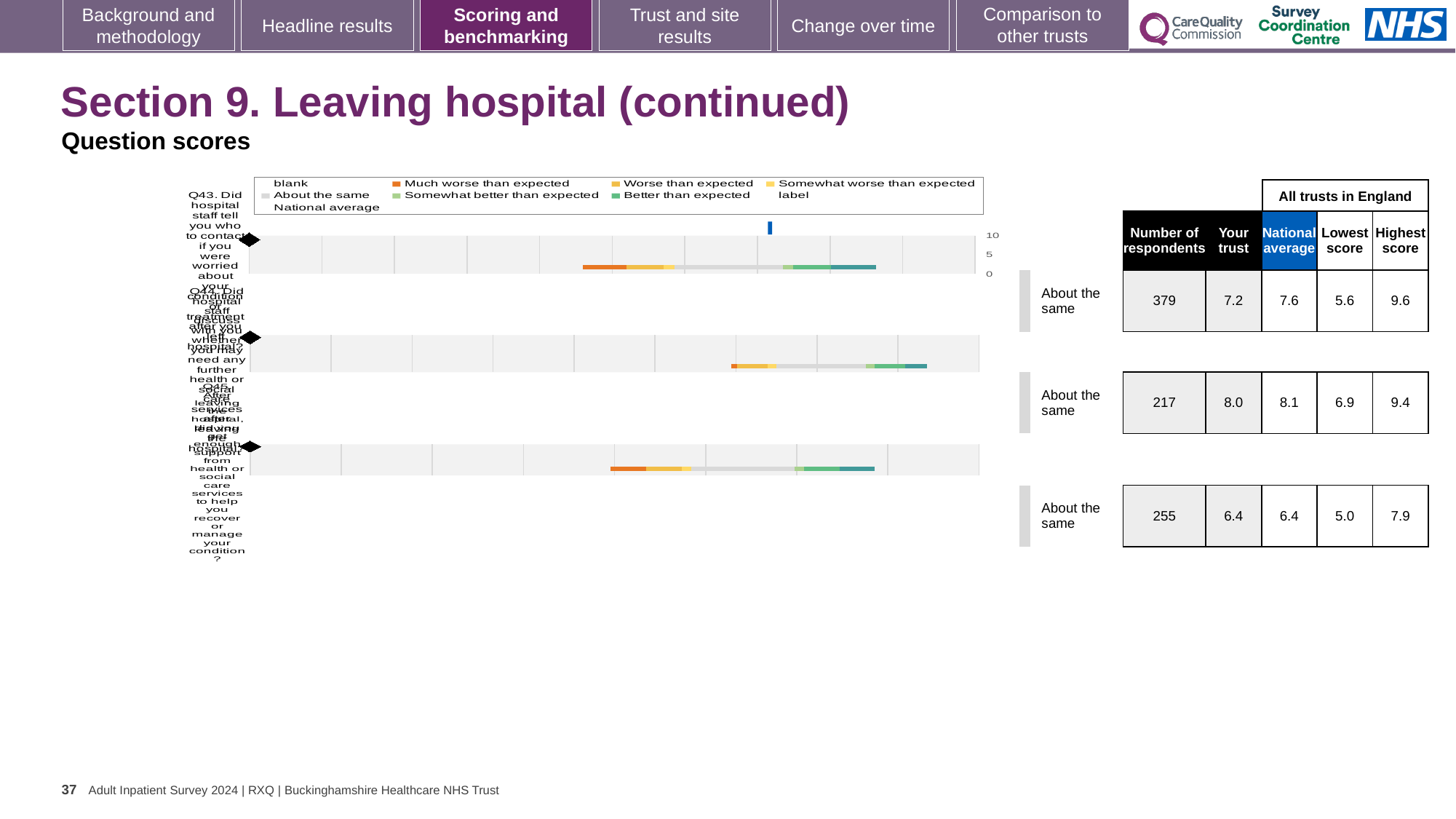
How many question rows are plotted in the chart? 3 What kind of chart is shown on the slide? bar chart In the table, what is the 'Your trust' score for the second question row? 8.0 Which question row has the highest 'Your trust' score? the second row (8.0) In the table, what is the national average for the third (bottom) question row? 6.4 For the first question row, what is the difference between the highest score and the lowest score? 4.0 In the table, what is the number of respondents for the first (top) question row? 379 In the table, what is the highest score among all trusts in England for the first question row? 9.6 Which question row has the lowest number of respondents? the second row (217) In the table, what is the lowest score among all trusts in England for the second question row? 6.9 For the first question row, which is larger: the 'Your trust' score or the national average? National average What benchmark category label is shown beside each of the three question rows? About the same